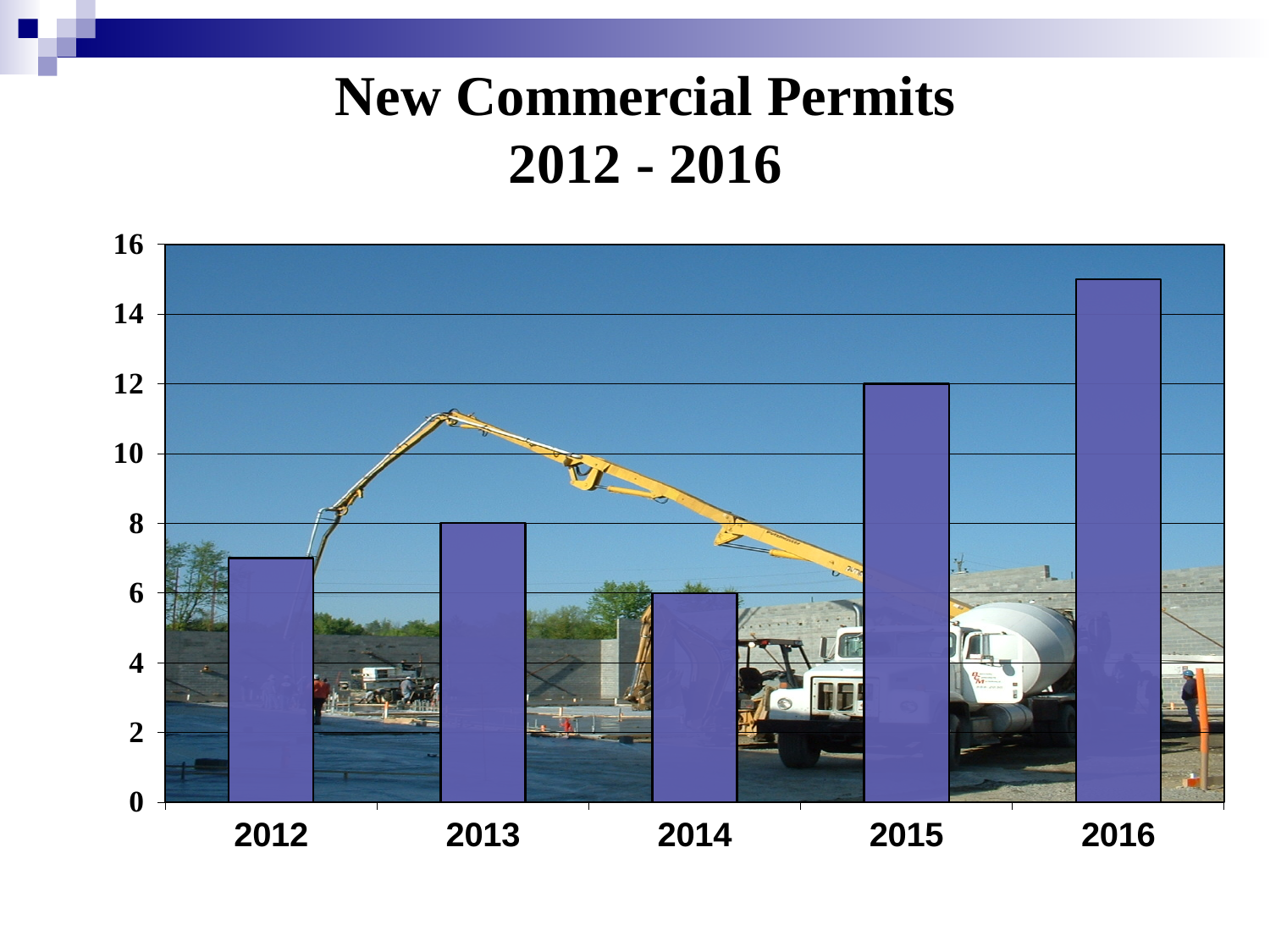
What is the value for 2013? 8 What type of chart is shown on the slide? bar chart Do the values rise or fall from 2014 to 2016? rise What is the title of the chart? New Commercial Permits 2012 - 2016 Is the value for 2012 greater or less than 8? less What is the difference between the values for 2015 and 2013? 4 What is the value for 2015? 12 How many years are shown on the x axis of the chart? 5 Which year has the lowest number of new commercial permits? 2014 Which year has the highest number of new commercial permits? 2016 What is the value for 2014? 6 Is the value for 2016 greater or less than 14? greater